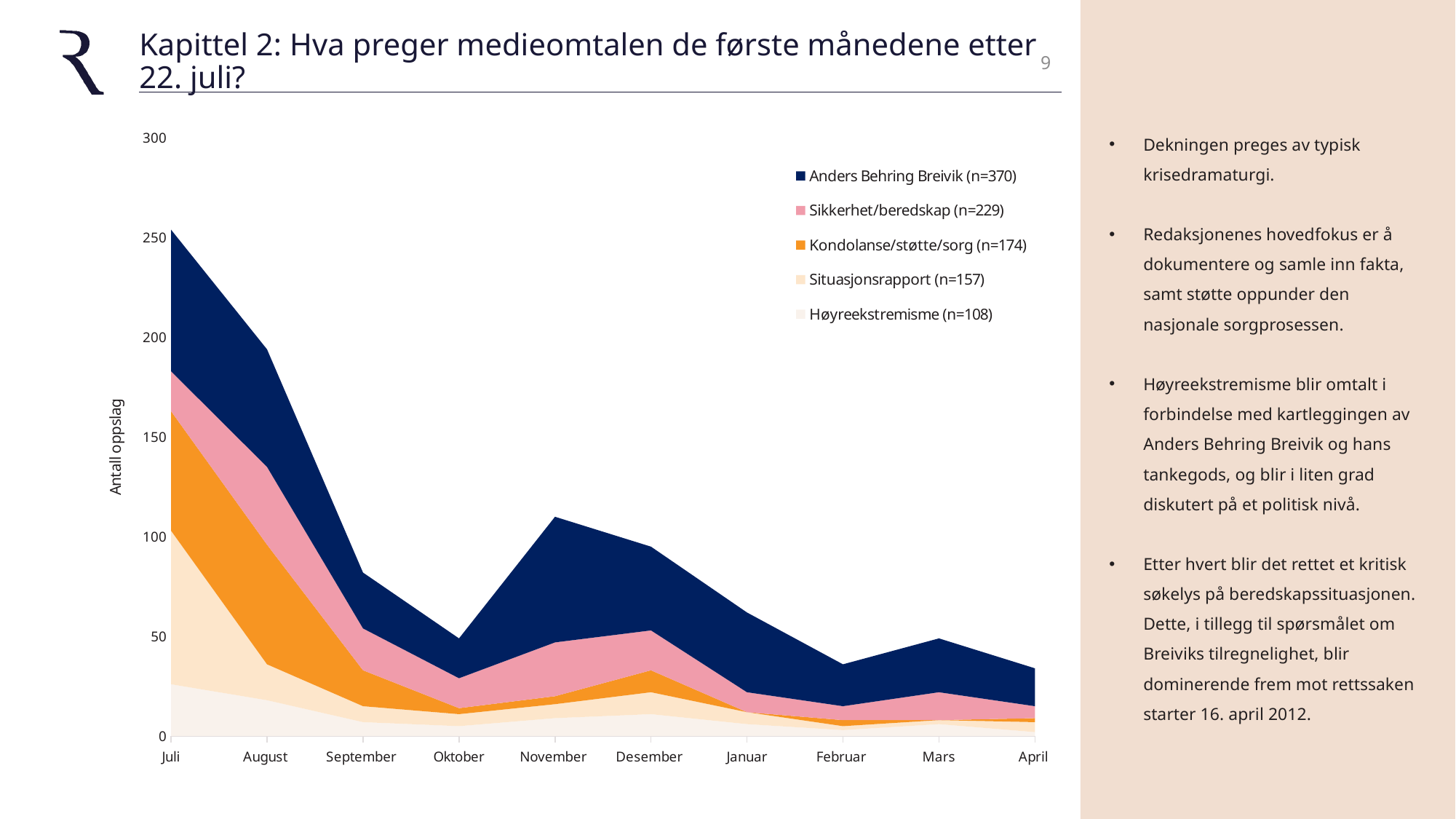
Is the total value for November greater or less than 150? less How many months are shown along the x axis? 10 Which month has the highest total number of articles (Antall oppslag)? Juli Which month has a larger total, Juli or August? Juli What is the n value shown in the legend for Anders Behring Breivik? n=370 What kind of chart is shown on the slide? Stacked area chart Is the total value for Oktober greater or less than 100? less Is the total value for Juli greater or less than 200? greater How many series does the legend list? 5 Does the total number of articles rise or fall from Juli to Oktober? Fall Which month has a larger total, Oktober or November? November